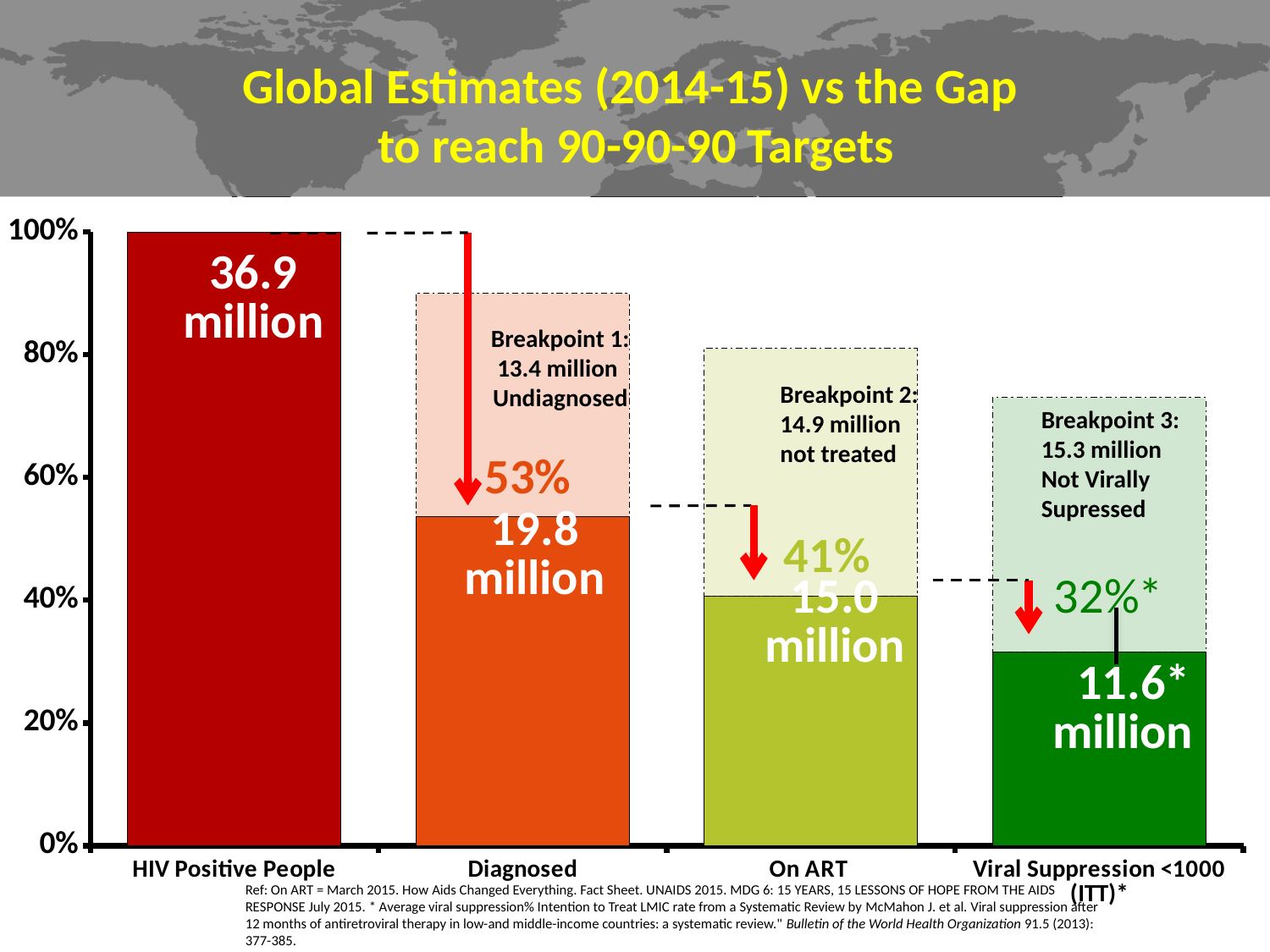
How many million people does Breakpoint 2 say are not treated? 14.9 million What value is labelled on the Diagnosed bar? 19.8 million What value is labelled on the HIV Positive People bar? 36.9 million What is the difference in millions between the Diagnosed bar and the On ART bar? 4.8 million Which category has the tallest bar? HIV Positive People How many categories are shown on the x axis? 4 What percentage is shown next to the On ART bar? 41% Do the bar heights rise or fall from left to right across the x axis? fall What value is labelled on the On ART bar? 15.0 million Which category has the shortest bar? Viral Suppression <1000 (ITT)* What percentage is shown next to the Viral Suppression <1000 (ITT)* bar? 32%* What percentage is shown next to the Diagnosed bar? 53%